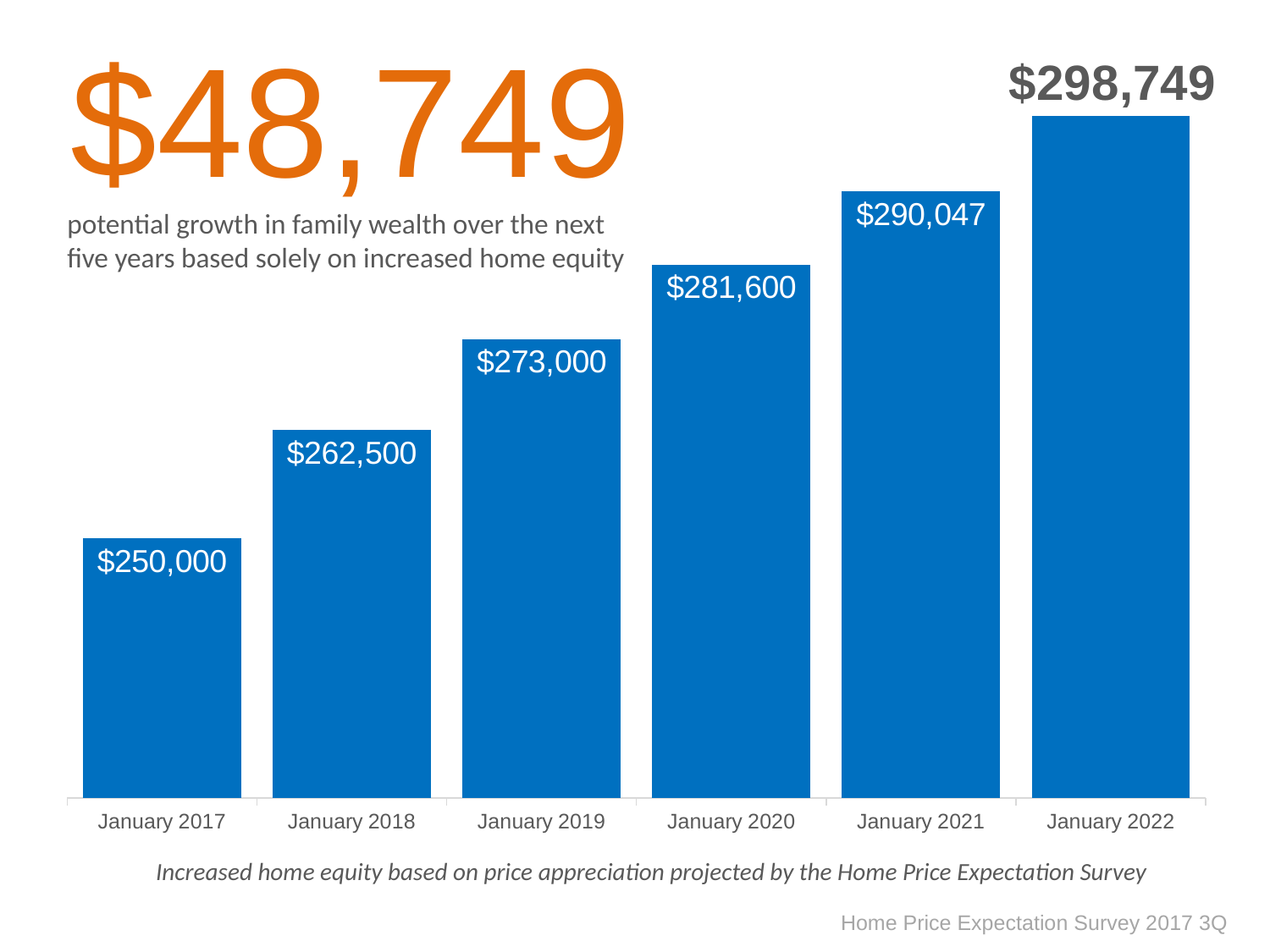
What source is cited at the bottom right of the slide? Home Price Expectation Survey 2017 3Q Do the values rise or fall from January 2017 to January 2022? Rise How many categories are shown on the x axis? 6 What is the value for January 2017? $250,000 What is the difference between the values for January 2019 and January 2018? $10,500 What kind of chart is this? Bar chart Which is larger, the value for January 2021 or the value for January 2019? January 2021 What is the value for January 2022? $298,749 What is the difference between the values for January 2022 and January 2017? $48,749 Which category has the lowest value? January 2017 Which category has the highest value? January 2022 What is the value for January 2020? $281,600